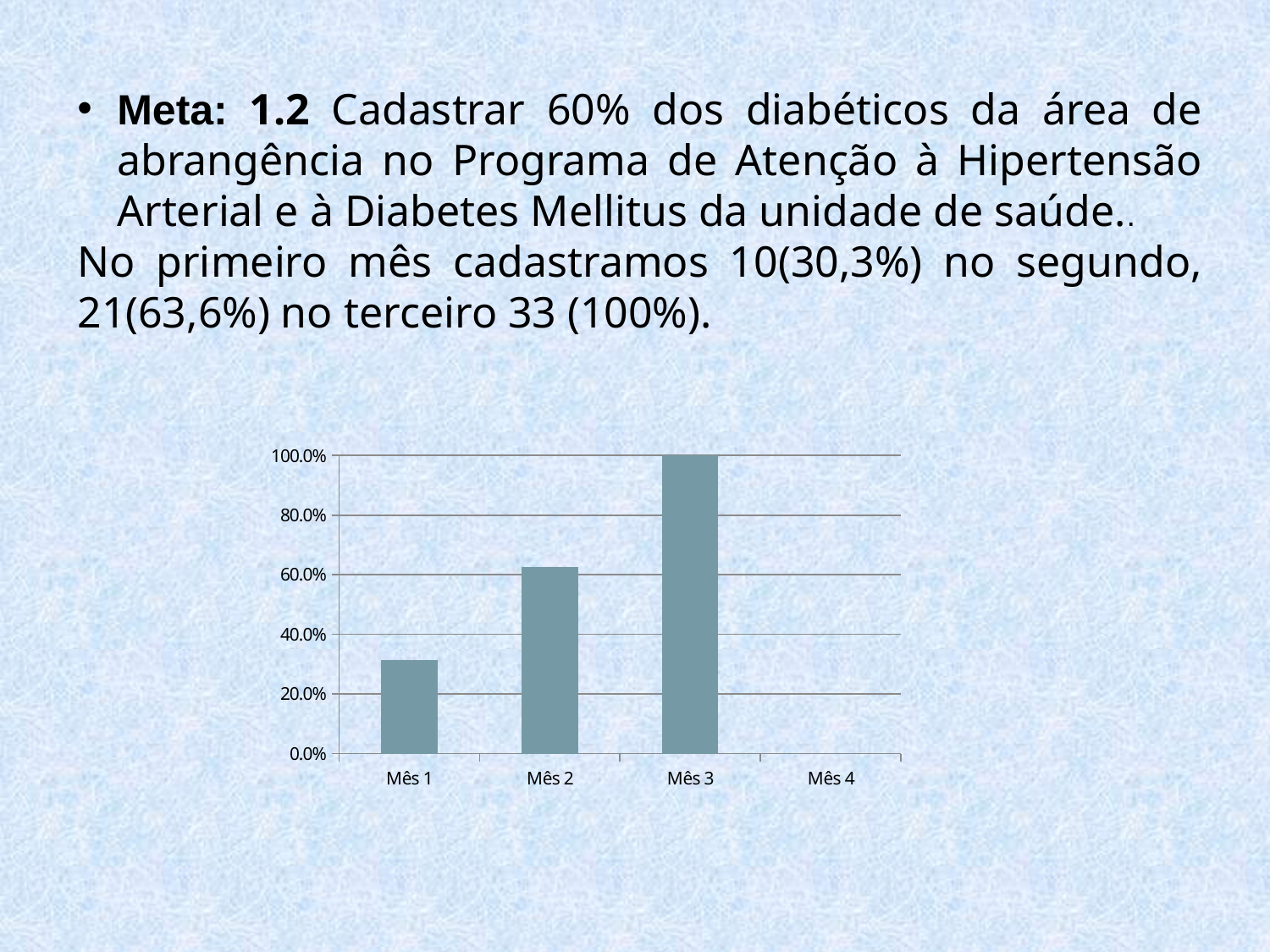
Which month with a plotted bar has the lowest value? Mês 1 What kind of chart is shown on the slide? bar chart How many bars are plotted in the chart? 3 Do the values rise or fall from Mês 1 to Mês 3? rise What is the value for Mês 3? 100.0% Which month has the highest bar? Mês 3 Is the value for Mês 1 greater or less than 40.0%? less Is the value for Mês 2 greater or less than 80.0%? less Which is larger, the value for Mês 1 or the value for Mês 2? Mês 2 Is the value for Mês 1 greater or less than 20.0%? greater How many category labels are shown on the x axis? 4